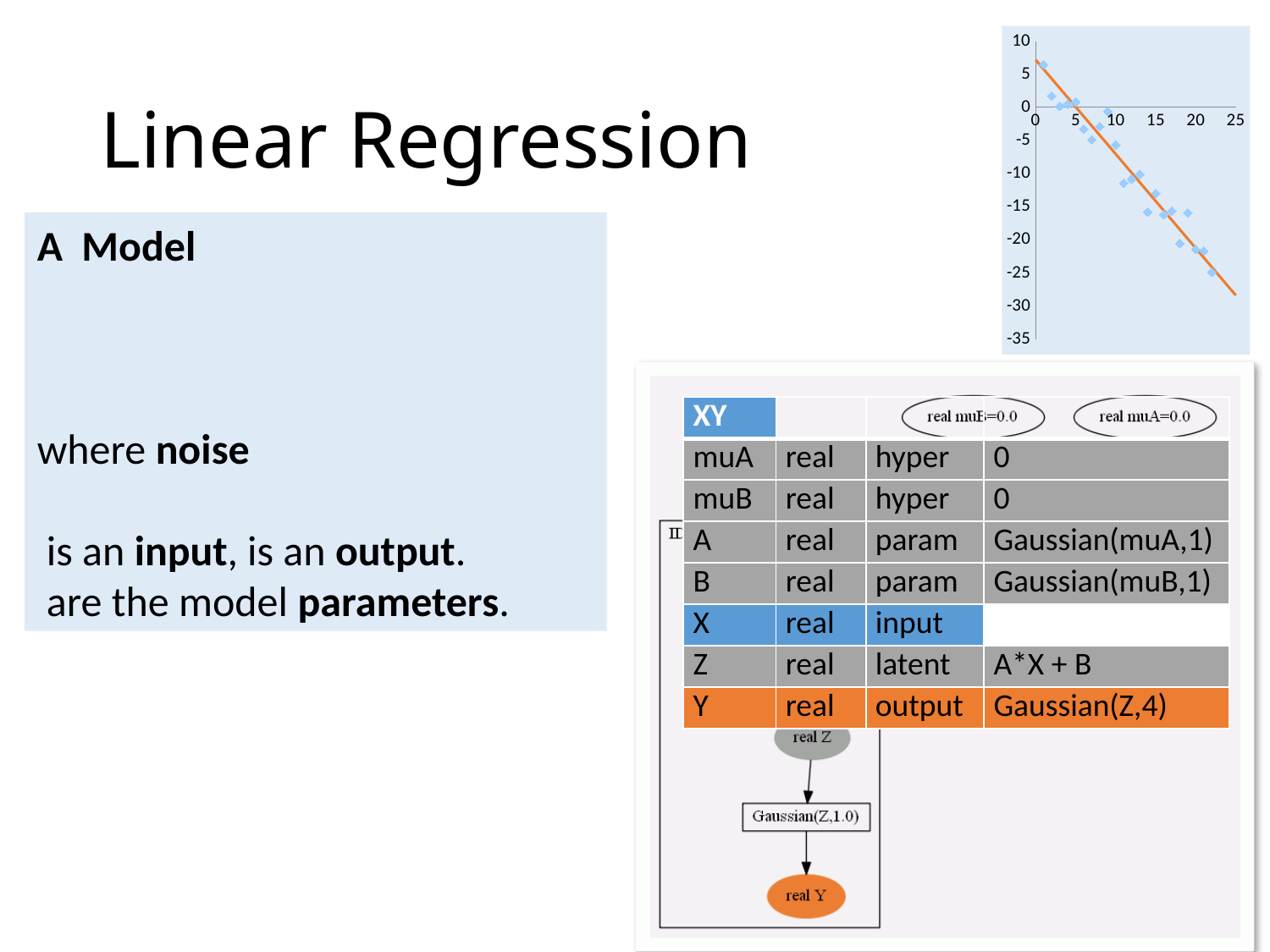
In the scatter chart, is the trend line's y value at x = 20 greater or less than -10? less In the scatter chart, do the plotted y values rise or fall as x increases? fall In the scatter chart, does the fitted trend line slope upward or downward from left to right? downward In the scatter chart, which has the larger y value: the leftmost point or the rightmost point? the leftmost point What is the lowest tick value shown on the y axis of the scatter chart? -35 In the scatter chart, is the y value of the rightmost point (near x = 23) greater or less than -20? less What kind of chart is shown in the top right of the slide? scatter chart What is the highest tick value shown on the y axis of the scatter chart? 10 In the scatter chart, are the plotted y values around x = 15 greater or less than -5? less